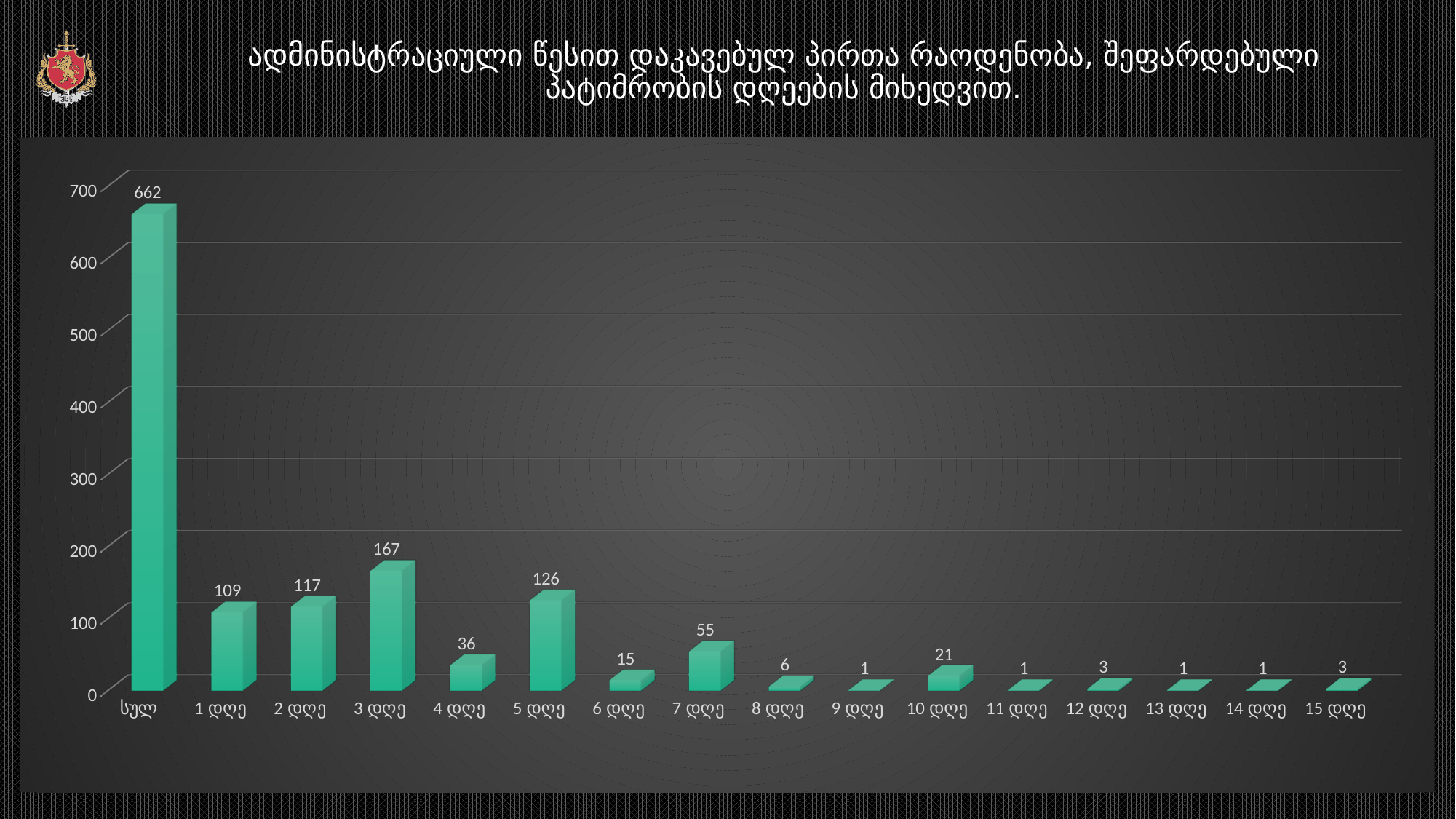
How many categories are shown on the x axis? 16 What is the value for "3 დღე"? 167 What is the difference between the values for "3 დღე" and "5 დღე"? 41 Excluding the "სულ" bar, which day category has the highest value? 3 დღე What is the value for "7 დღე"? 55 What is the value for "სულ"? 662 What is the value for "10 დღე"? 21 Which is larger, the value for "4 დღე" or the value for "7 დღე"? 7 დღე Which is larger, the value for "1 დღე" or the value for "5 დღე"? 5 დღე What kind of chart is shown on the slide? Bar chart What is the highest value shown on the vertical axis? 700 What is the difference between the values for "2 დღე" and "1 დღე"? 8